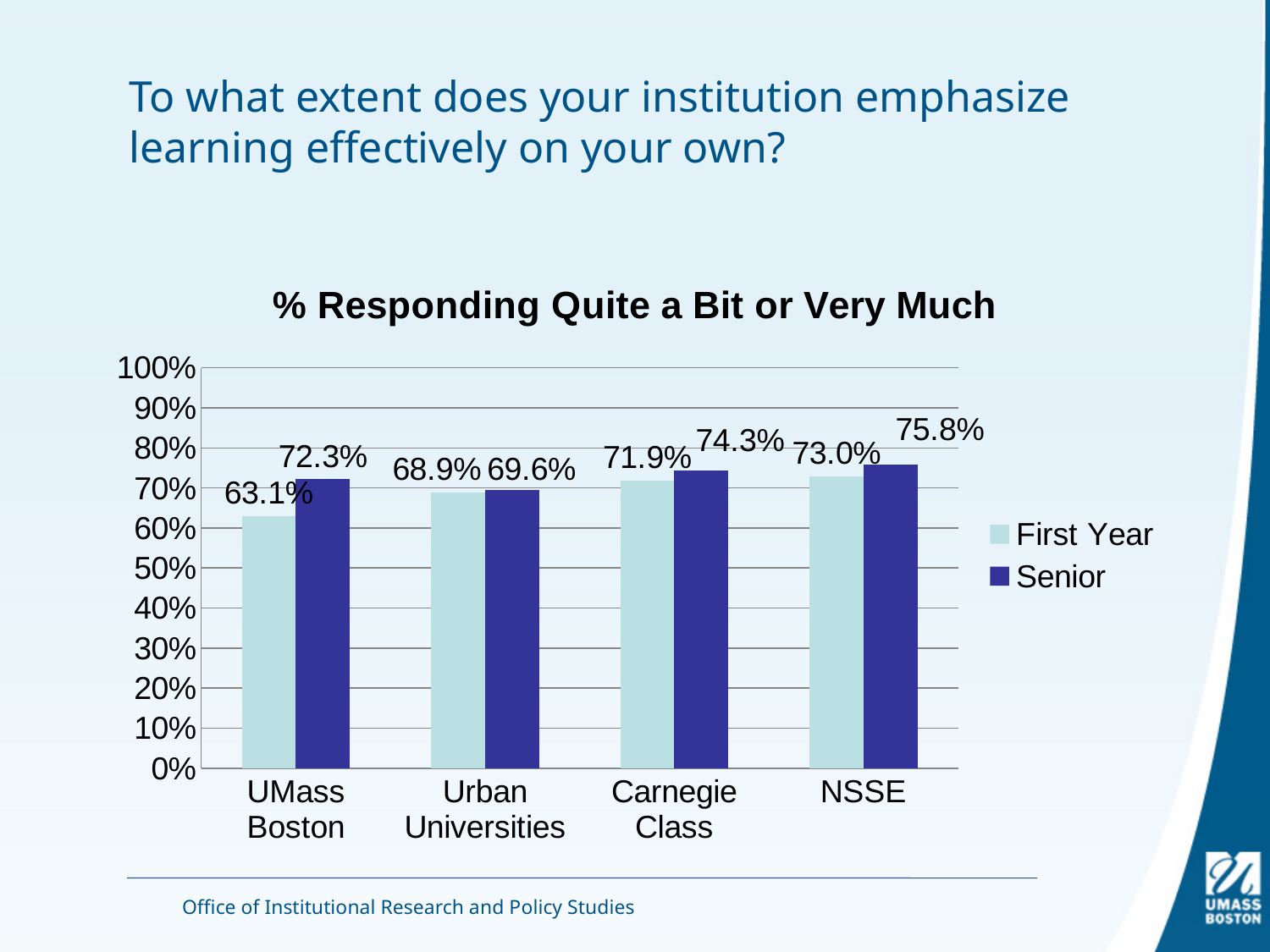
What is the Senior value for Urban Universities? 69.6% Which category has the highest Senior value? NSSE What is the First Year value for Carnegie Class? 71.9% What is the title of the chart? % Responding Quite a Bit or Very Much What is the First Year value for UMass Boston? 63.1% How many categories are shown on the x axis? 4 What is the difference between the Senior and First Year values for UMass Boston? 9.2% Which category has the lowest First Year value? UMass Boston Which is larger for Carnegie Class, the First Year value or the Senior value? Senior What kind of chart is shown on the slide? Bar chart How many series does the legend list? 2 What is the Senior value for NSSE? 75.8%